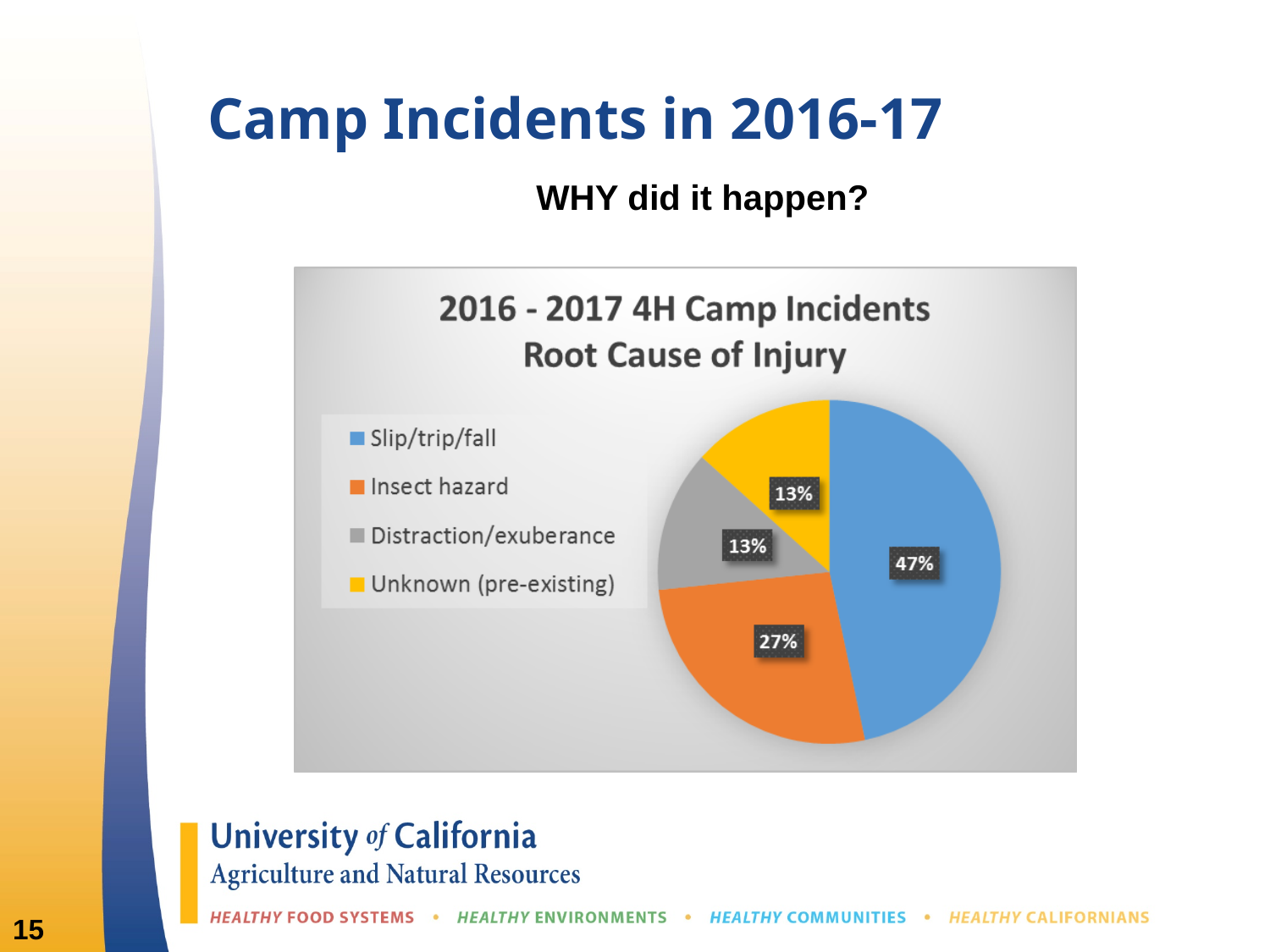
Which root cause accounts for the largest share of camp incidents? Slip/trip/fall What is the difference in percentage points between Slip/trip/fall and Insect hazard? 20 What is the combined share of Distraction/exuberance and Unknown (pre-existing)? 26% How many root cause categories does the pie chart show? 4 What percentage of camp incidents were caused by Insect hazard? 27% What is the title of the chart? 2016 - 2017 4H Camp Incidents Root Cause of Injury What percentage of camp incidents were caused by Slip/trip/fall? 47% What type of chart is shown on the slide? Pie chart Which is larger: the share for Insect hazard or the share for Distraction/exuberance? Insect hazard Which colour represents Unknown (pre-existing) in the pie chart? Yellow What percentage of camp incidents had an Unknown (pre-existing) root cause? 13% What percentage of camp incidents were attributed to Distraction/exuberance? 13%